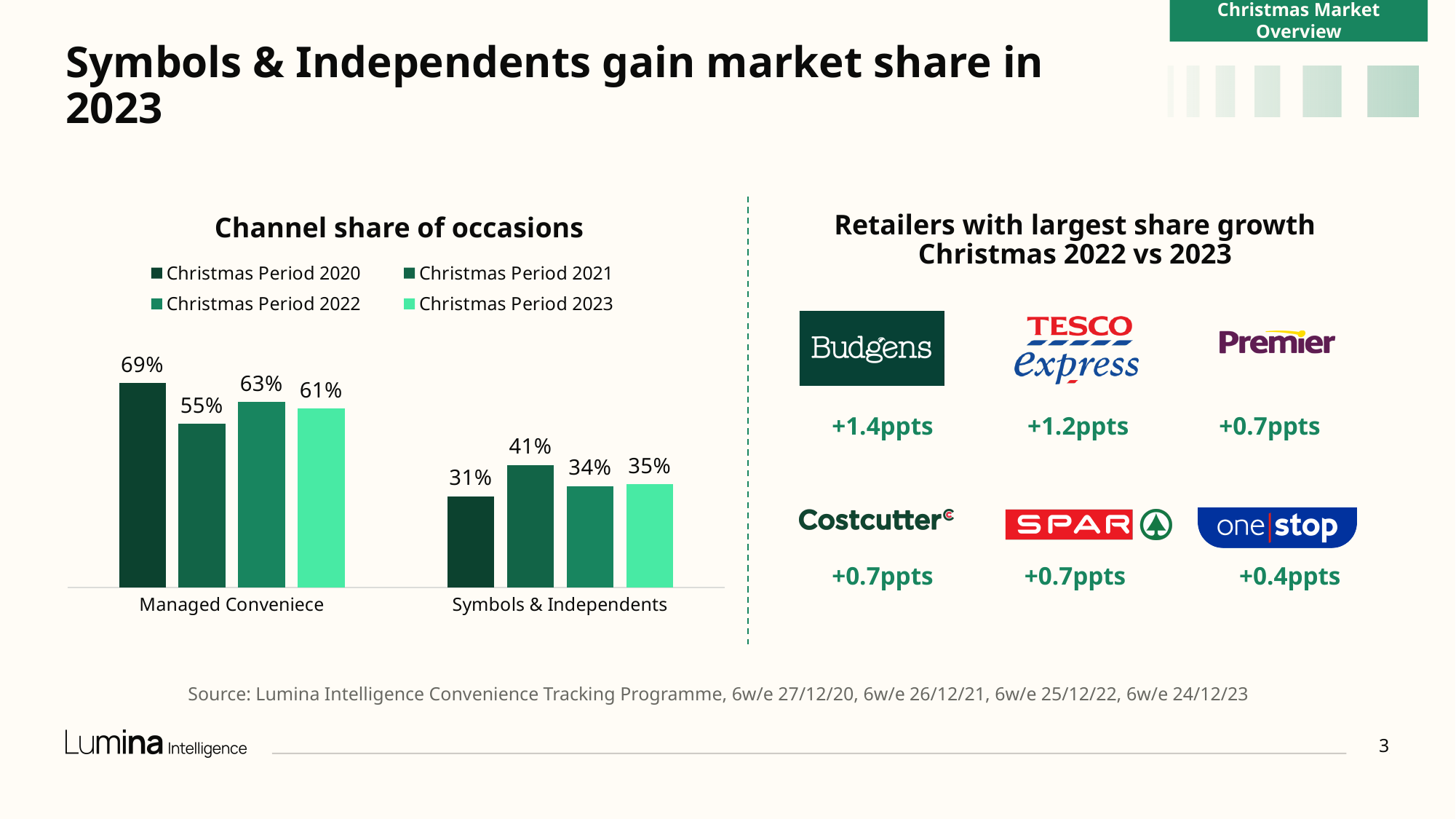
In the Channel share of occasions chart, which is larger: Managed Conveniece in Christmas Period 2022 or Managed Conveniece in Christmas Period 2023? Christmas Period 2022 In the Channel share of occasions chart, what is the value for Managed Conveniece in Christmas Period 2022? 63% In the Channel share of occasions chart, what is the value for Symbols & Independents in Christmas Period 2021? 41% What kind of chart is the Channel share of occasions chart? Bar chart In the Channel share of occasions chart, what is the value for Symbols & Independents in Christmas Period 2023? 35% In the Channel share of occasions chart, which Christmas Period has the lowest value for Symbols & Independents? Christmas Period 2020 In the Channel share of occasions chart, which Christmas Period has the highest value for Managed Conveniece? Christmas Period 2020 In the Channel share of occasions chart, what is the value for Managed Conveniece in Christmas Period 2020? 69% How many series does the legend of the Channel share of occasions chart list? 4 In the Channel share of occasions chart, what is the difference between the Managed Conveniece values for Christmas Period 2020 and Christmas Period 2021? 14% How many categories are shown on the x axis of the Channel share of occasions chart? 2 In the Channel share of occasions chart, what is the difference between the Symbols & Independents values for Christmas Period 2023 and Christmas Period 2022? 1%